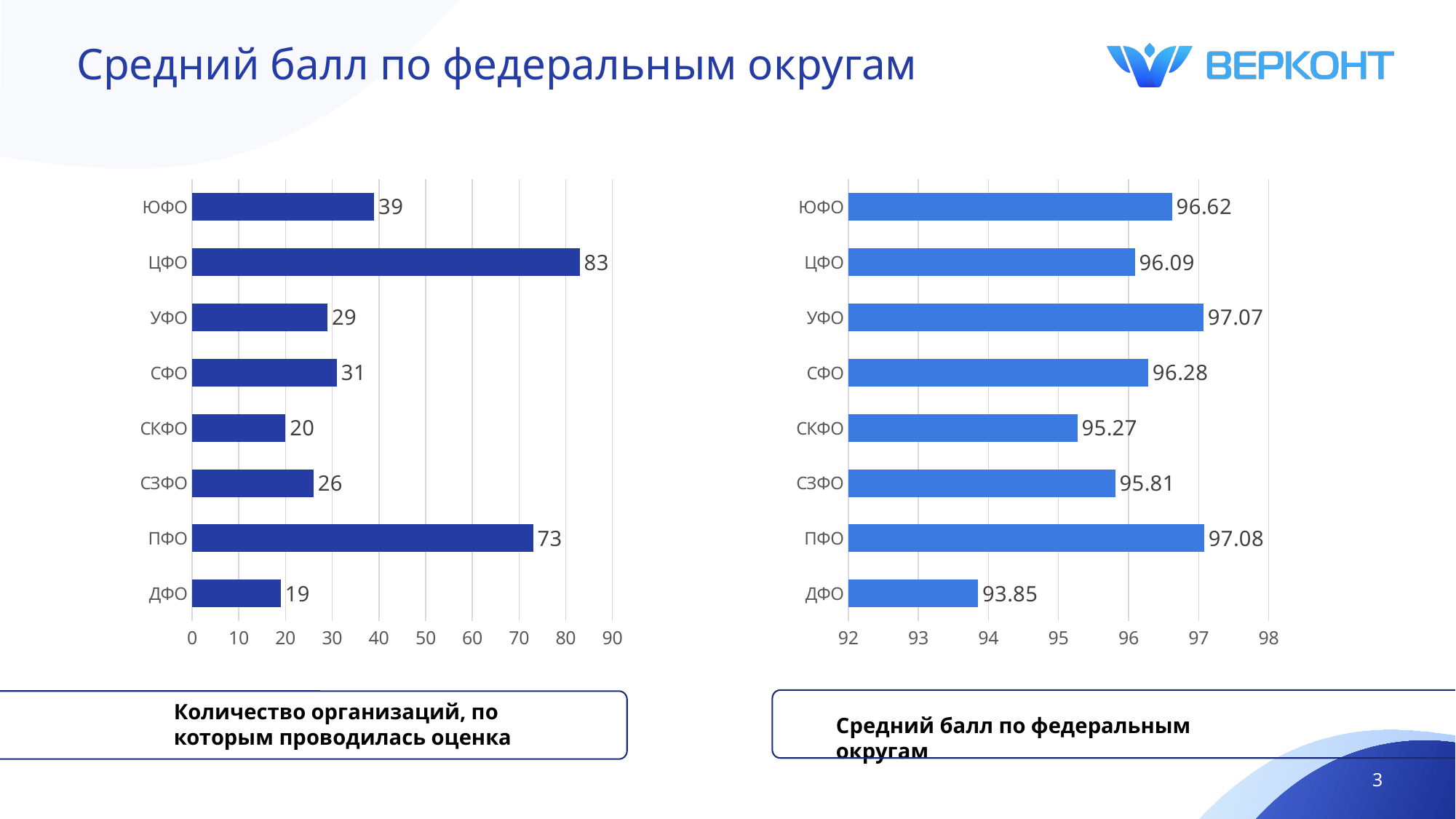
In the left chart (Количество организаций, по которым проводилась оценка), how many federal districts are shown? 8 In the left chart (Количество организаций, по которым проводилась оценка), what is the difference between the values for ЦФО and ПФО? 10 In the right chart (Средний балл по федеральным округам), what is the difference between the values for ЮФО and ЦФО? 0.53 In the right chart (Средний балл по федеральным округам), what is the value for СКФО? 95.27 In the right chart (Средний балл по федеральным округам), which federal district has the lowest average score? ДФО What is the title of the slide? Средний балл по федеральным округам In the left chart (Количество организаций, по которым проводилась оценка), which federal district has the lowest value? ДФО In the left chart (Количество организаций, по которым проводилась оценка), which federal district has the highest value? ЦФО In the right chart (Средний балл по федеральным округам), is the value for СЗФО greater or less than 96? less In the left chart (Количество организаций, по которым проводилась оценка), what is the value for ЦФО? 83 In the left chart (Количество организаций, по которым проводилась оценка), which is larger, the value for ЮФО or the value for СФО? ЮФО What kind of chart is the right chart (Средний балл по федеральным округам)? bar chart